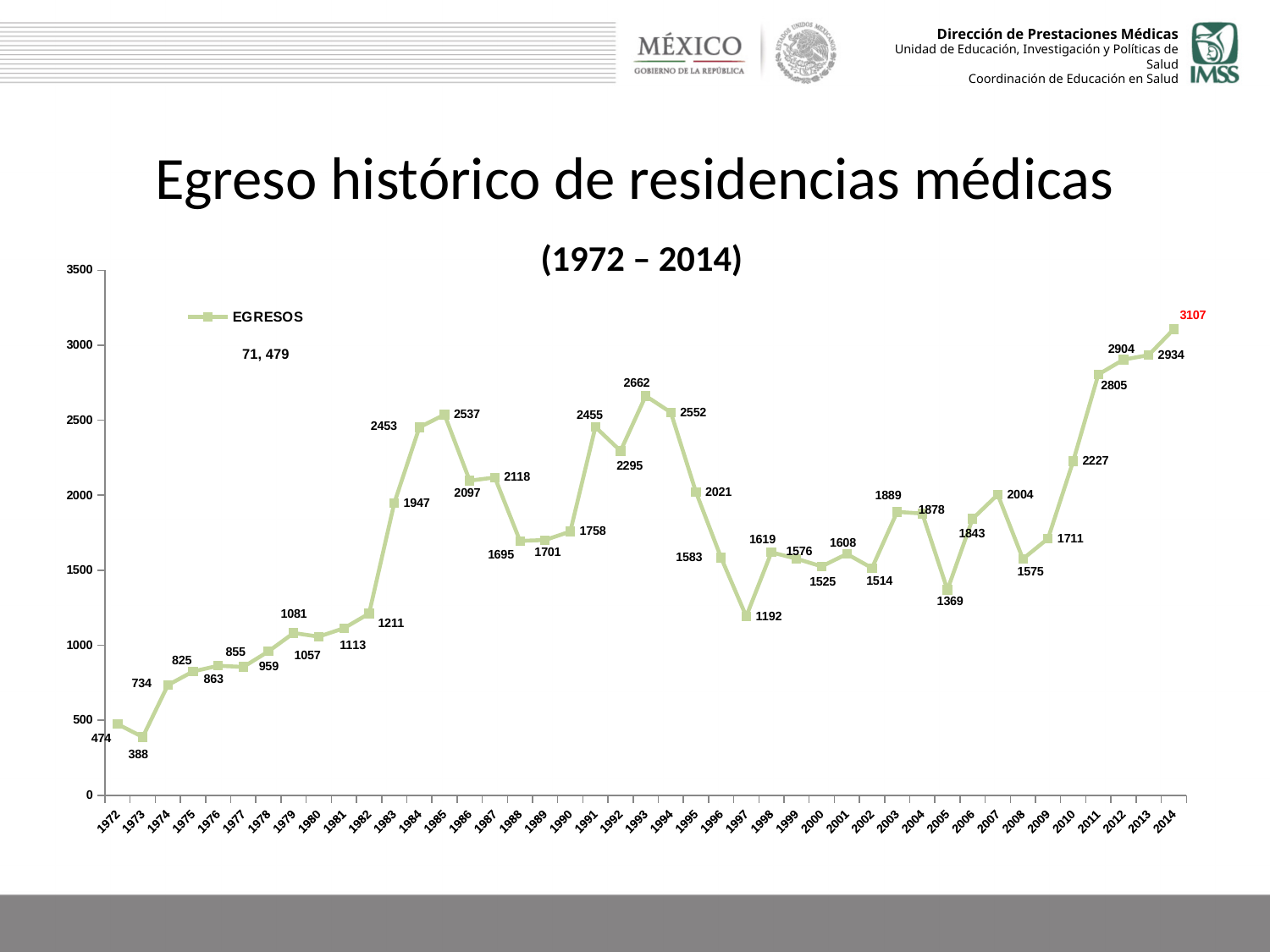
What is the difference between the EGRESOS values for 2014 and 2013? 173 What is the value of EGRESOS for 2005? 1369 Which year has the lowest value of EGRESOS? 1973 What is the name of the series shown in the legend? EGRESOS Which year has the highest value of EGRESOS? 2014 What type of chart is shown on the slide? Line chart What is the value of EGRESOS for 1993? 2662 Which year has a larger EGRESOS value, 1985 or 1991? 1985 How many series does the legend list? 1 What is the value of EGRESOS for 2014? 3107 Is the value for 2010 greater or less than 2000? greater What is the difference between the EGRESOS values for 1997 and 1996? 391